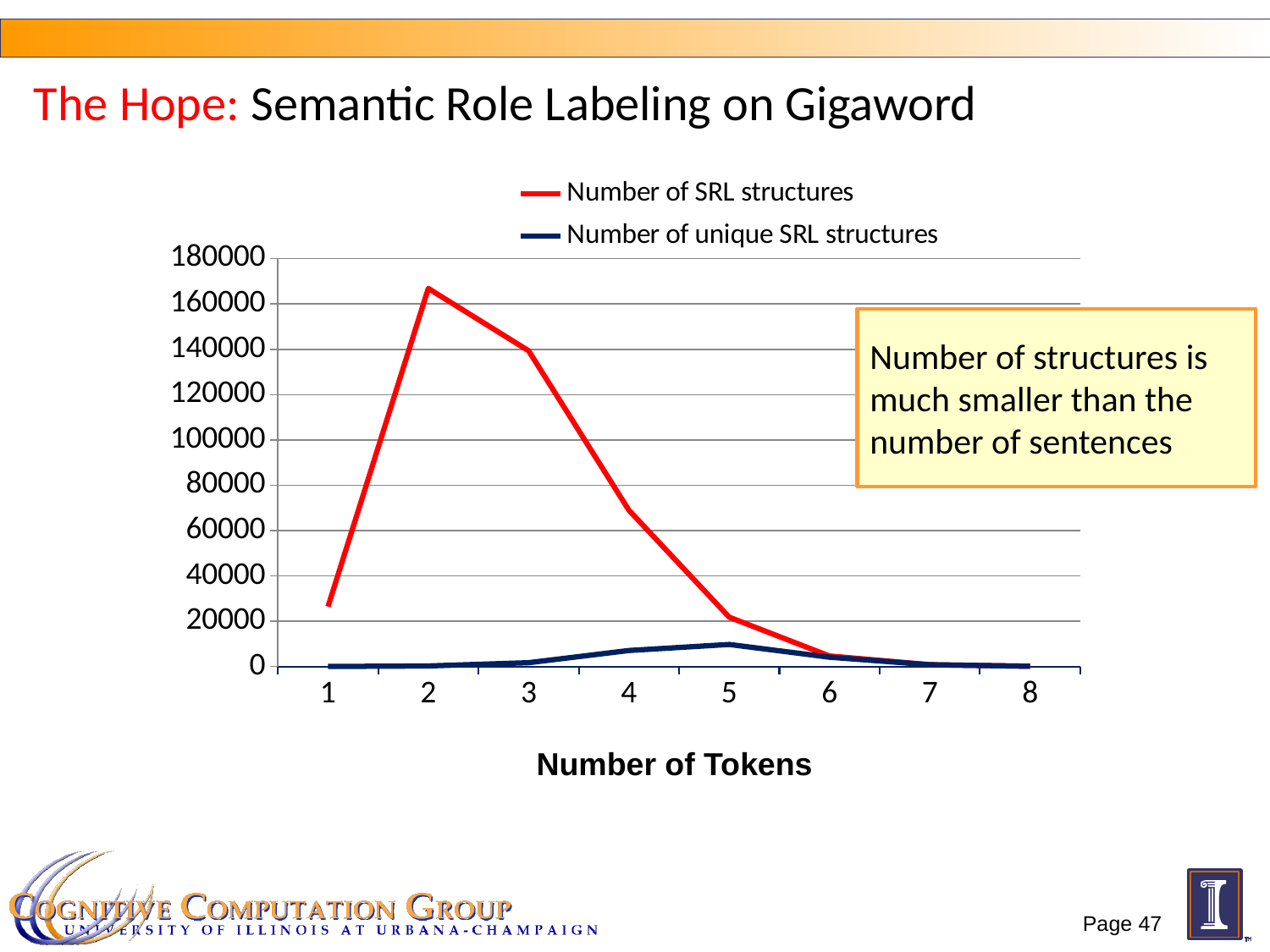
Which is larger: the Number of SRL structures at 2 tokens or at 3 tokens? 2 tokens Is the Number of SRL structures at 4 tokens greater or less than 80000? less Is the Number of SRL structures at 1 token greater or less than 40000? less How many points along the x axis (Number of Tokens) are plotted for each series? 8 At which number of tokens is the Number of unique SRL structures highest? 5 From 2 tokens to 8 tokens, does the Number of SRL structures rise or fall? fall How many series does the legend list? 2 Is the Number of SRL structures at 2 tokens greater or less than 140000? greater What kind of chart is shown on the slide? line chart At which number of tokens is the Number of SRL structures highest? 2 What is the title of the x axis? Number of Tokens